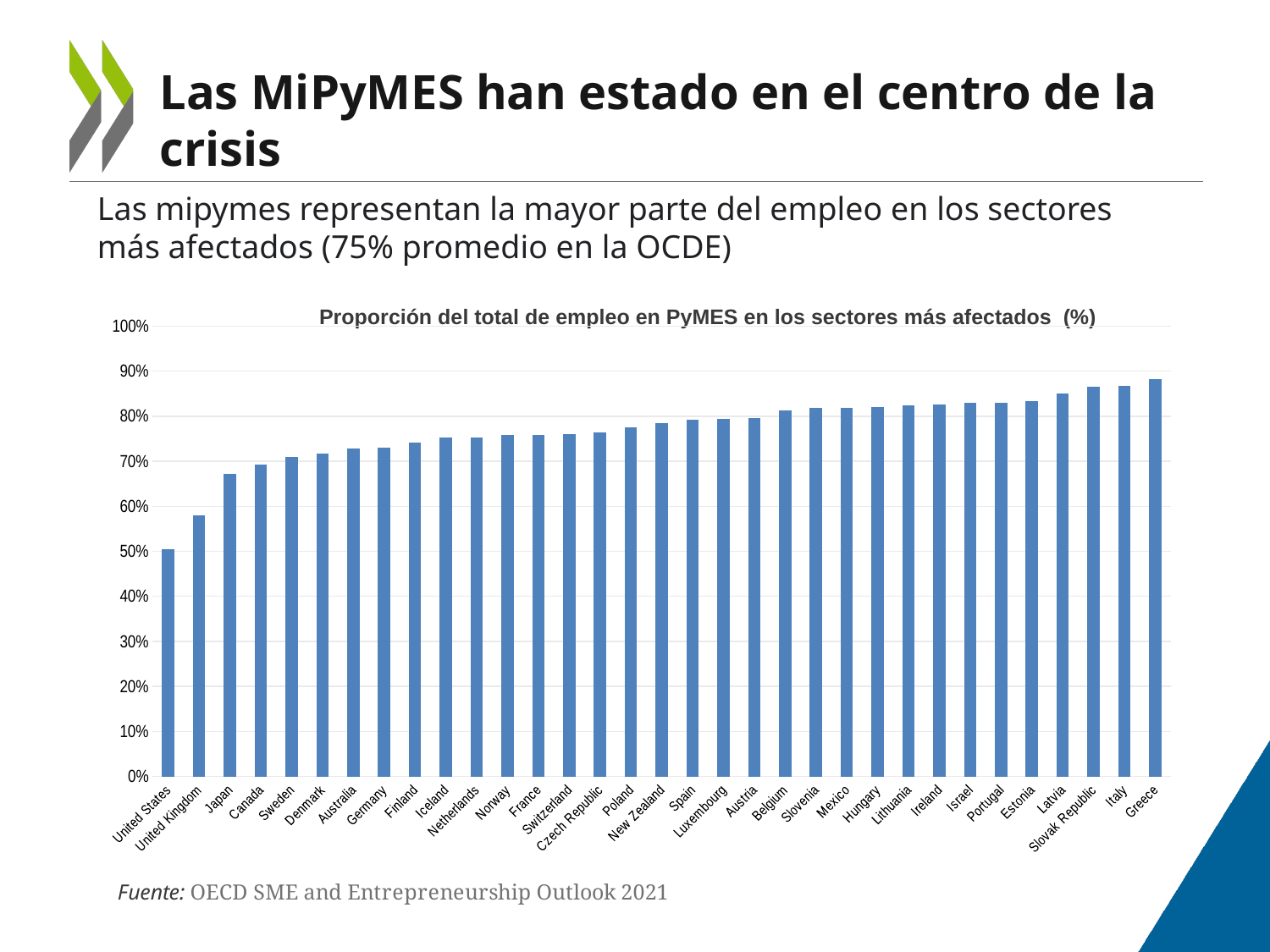
Is the value for Japan greater or less than 70%? less Is the value for Norway greater or less than 80%? less How many countries are shown in the chart? 33 Which has a larger value, Japan or Italy? Italy Is the value for the United Kingdom greater or less than 60%? less Do the values rise or fall from left to right across the countries? rise What kind of chart is shown on the slide? bar chart Which country has the lowest value in the chart? United States What is the title of the chart? Proporción del total de empleo en PyMES en los sectores más afectados (%) Which country has the highest value in the chart? Greece